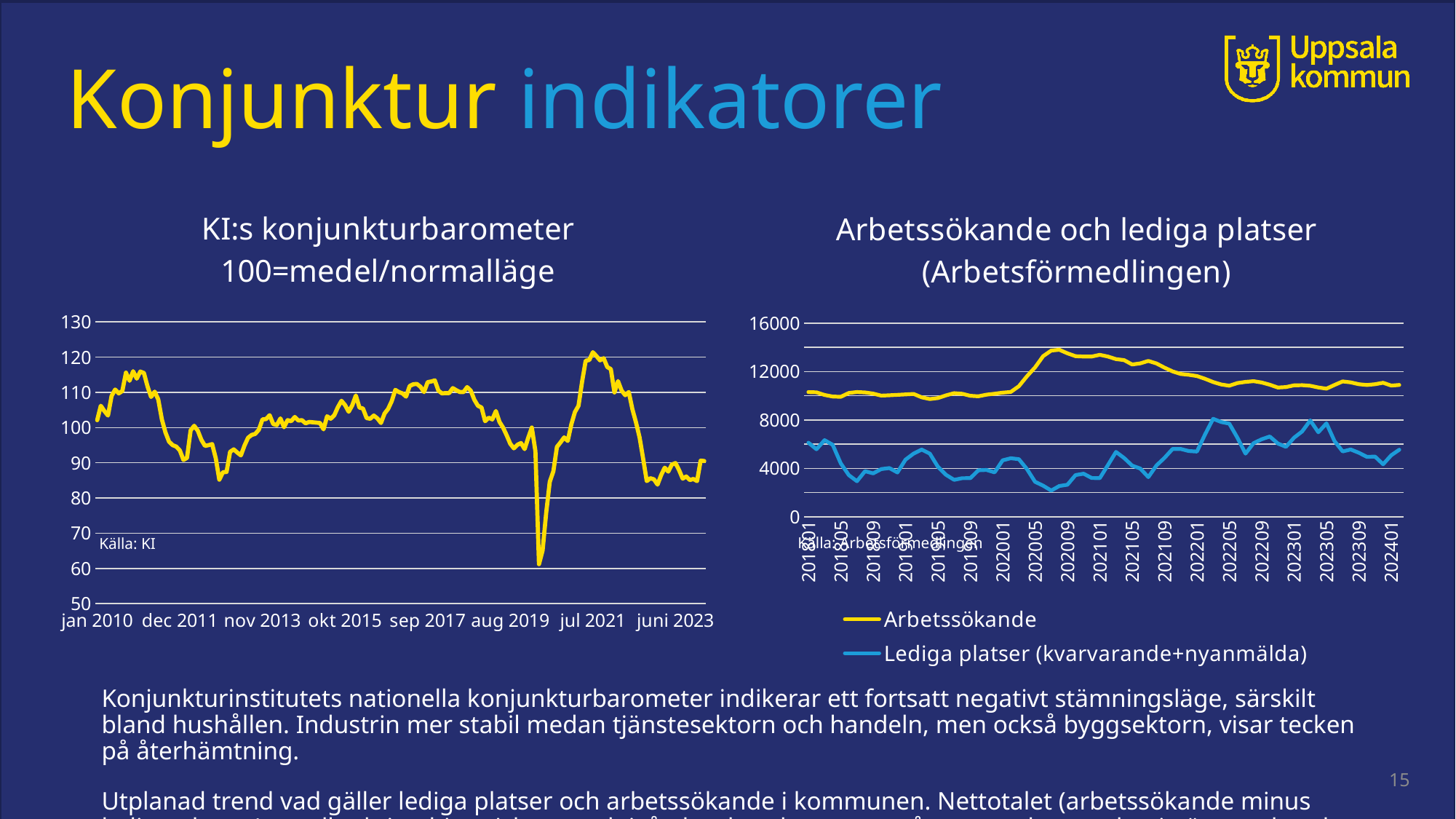
In the 'Arbetssökande och lediga platser' chart, is the value of Arbetssökande at 202401 greater or less than 8000? greater In the 'KI:s konjunkturbarometer' chart, is the highest value of the line (around 2021) greater or less than 110? greater In the 'Arbetssökande och lediga platser' chart, is the peak value of Arbetssökande (around 2020) greater or less than 12000? greater In the 'Arbetssökande och lediga platser' chart, which series is drawn in yellow? Arbetssökande In the 'Arbetssökande och lediga platser' chart, which series has the higher values throughout the period, Arbetssökande or Lediga platser? Arbetssökande What kind of chart is the 'Arbetssökande och lediga platser' chart on the right? line chart How many series does the legend of the 'Arbetssökande och lediga platser' chart list? 2 In the 'Arbetssökande och lediga platser' chart, what is the full legend label of the blue series? Lediga platser (kvarvarande+nyanmälda) What kind of chart is the 'KI:s konjunkturbarometer' chart on the left? line chart